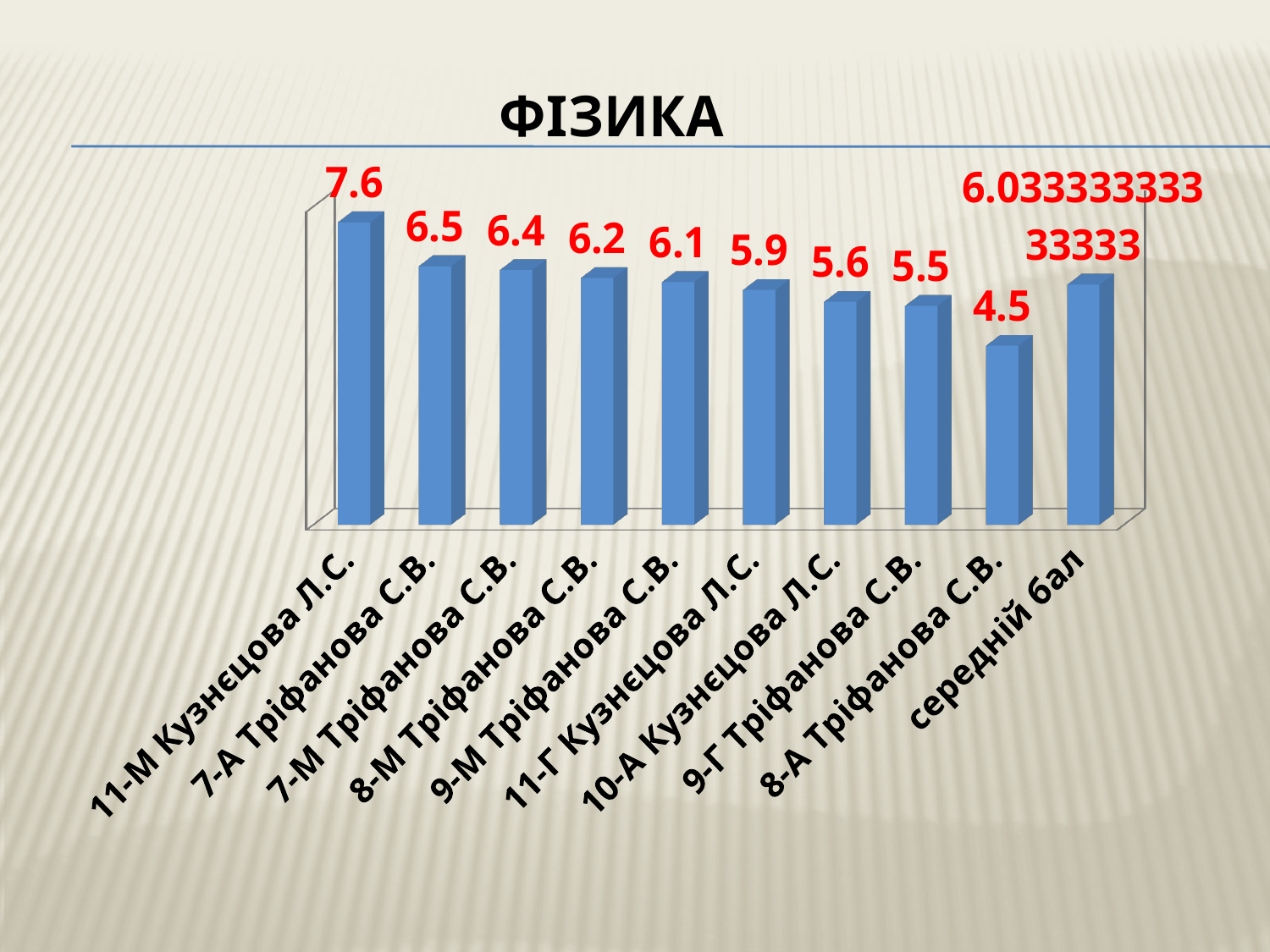
What is the value for 9-М Тріфанова С.В.? 6.1 How many bars are shown in the chart? 10 What is the value for 10-А Кузнєцова Л.С.? 5.6 Which category has the lowest value? 8-А Тріфанова С.В. What is the value for 11-М Кузнєцова Л.С.? 7.6 Which category has the highest value? 11-М Кузнєцова Л.С. What is the difference between the values for 7-А Тріфанова С.В. and 9-Г Тріфанова С.В.? 1.0 Which is larger, the value for 8-М Тріфанова С.В. or the value for 11-Г Кузнєцова Л.С.? 8-М Тріфанова С.В. What is the difference between the values for 11-М Кузнєцова Л.С. and 8-А Тріфанова С.В.? 3.1 What kind of chart is shown on the slide? Bar chart What is the title of the slide? ФІЗИКА What is the value for 8-А Тріфанова С.В.? 4.5